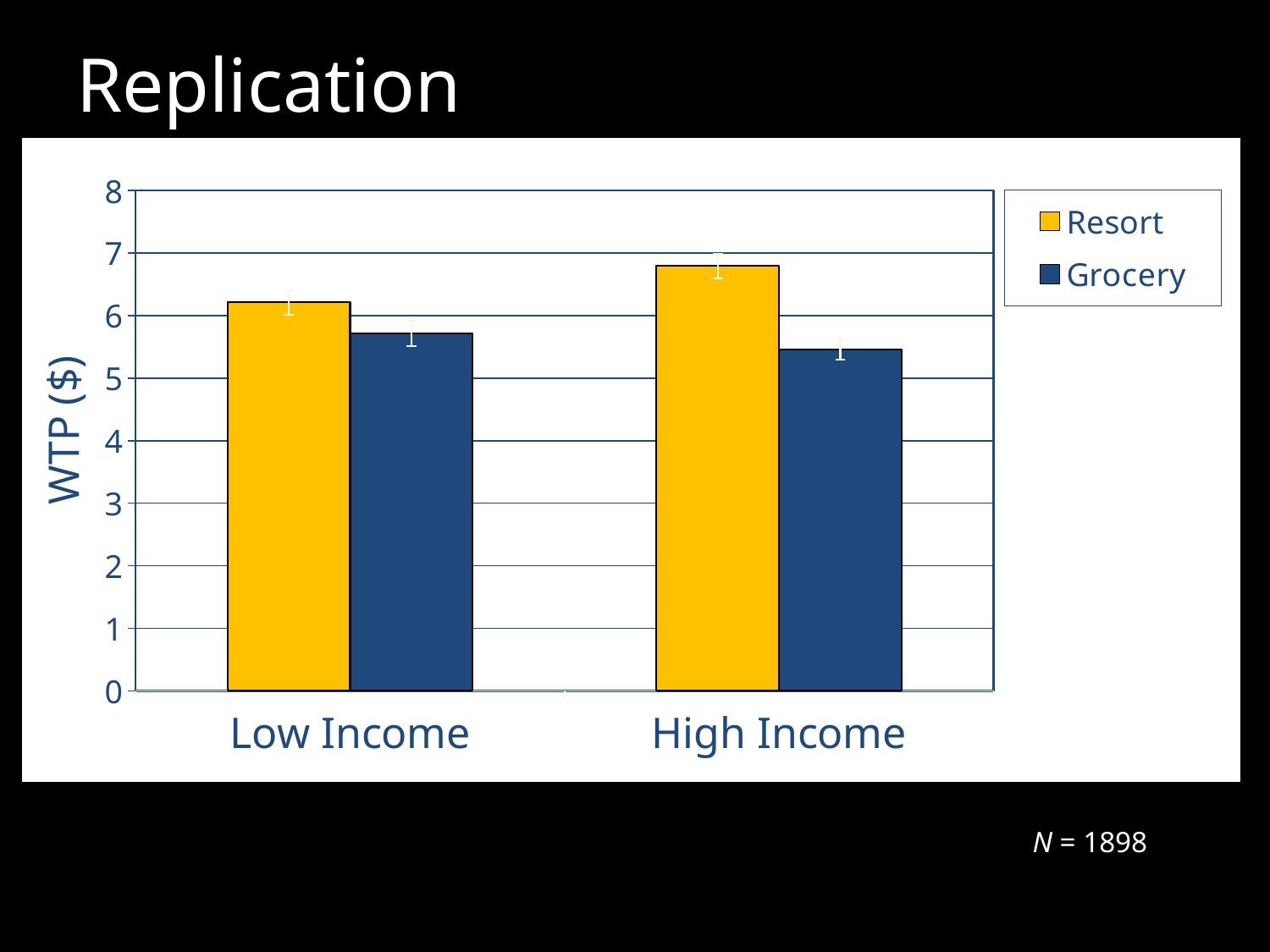
Which series is shown in yellow? Resort For the Resort series, which income group has the larger value? High Income Is the Resort value for Low Income greater or less than 6? greater Is the Resort value for High Income greater or less than 7? less Is the Grocery value for High Income greater or less than 5? greater How many income categories are shown on the x axis? 2 What is the label of the y axis? WTP ($) How many series does the legend list? 2 What kind of chart is shown on the slide? bar chart For Low Income, which is larger, Resort or Grocery? Resort Which bar is the highest on the chart? Resort for High Income